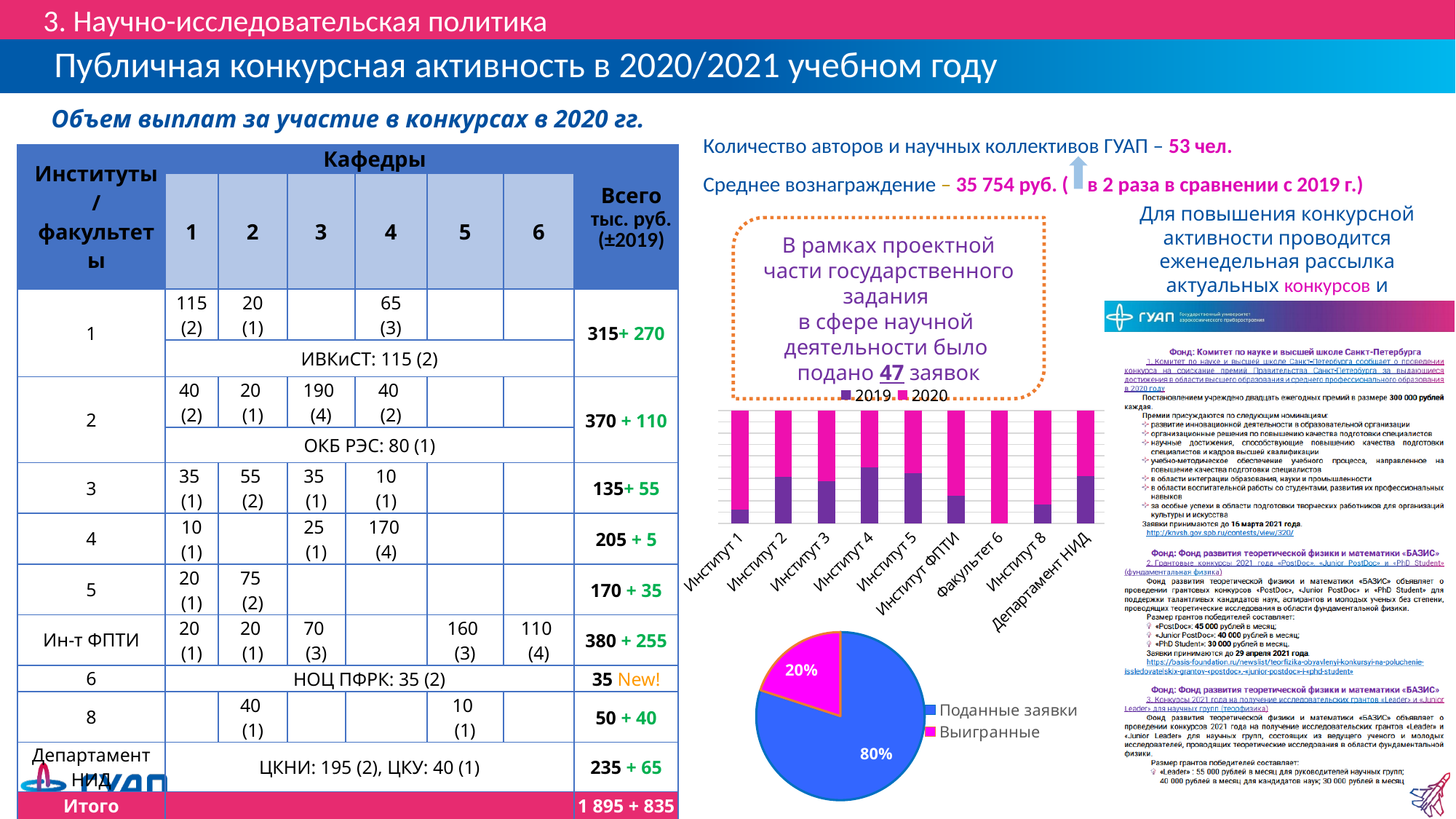
In the pie chart, what is the difference between the 'Поданные заявки' share and the 'Выигранные' share? 60% How many categories are shown on the x axis of the 2019/2020 bar chart? 9 In the 2019/2020 bar chart, which series is shown in magenta? 2020 In the pie chart, which slice is larger, 'Поданные заявки' or 'Выигранные'? Поданные заявки What kind of chart is the chart with the legend '2019' and '2020' in the middle of the slide? bar chart In the pie chart, what colour is the 'Выигранные' slice? magenta What kind of chart is the chart at the bottom right of the slide with the 20% and 80% slices? pie chart In the pie chart, what share is labelled for the 'Выигранные' slice? 20% How many slices does the pie chart have? 2 In the pie chart, what share is labelled for the 'Поданные заявки' slice? 80% In the 2019/2020 bar chart, which category is listed last on the x axis? Департамент НИД How many series does the legend of the 2019/2020 bar chart list? 2